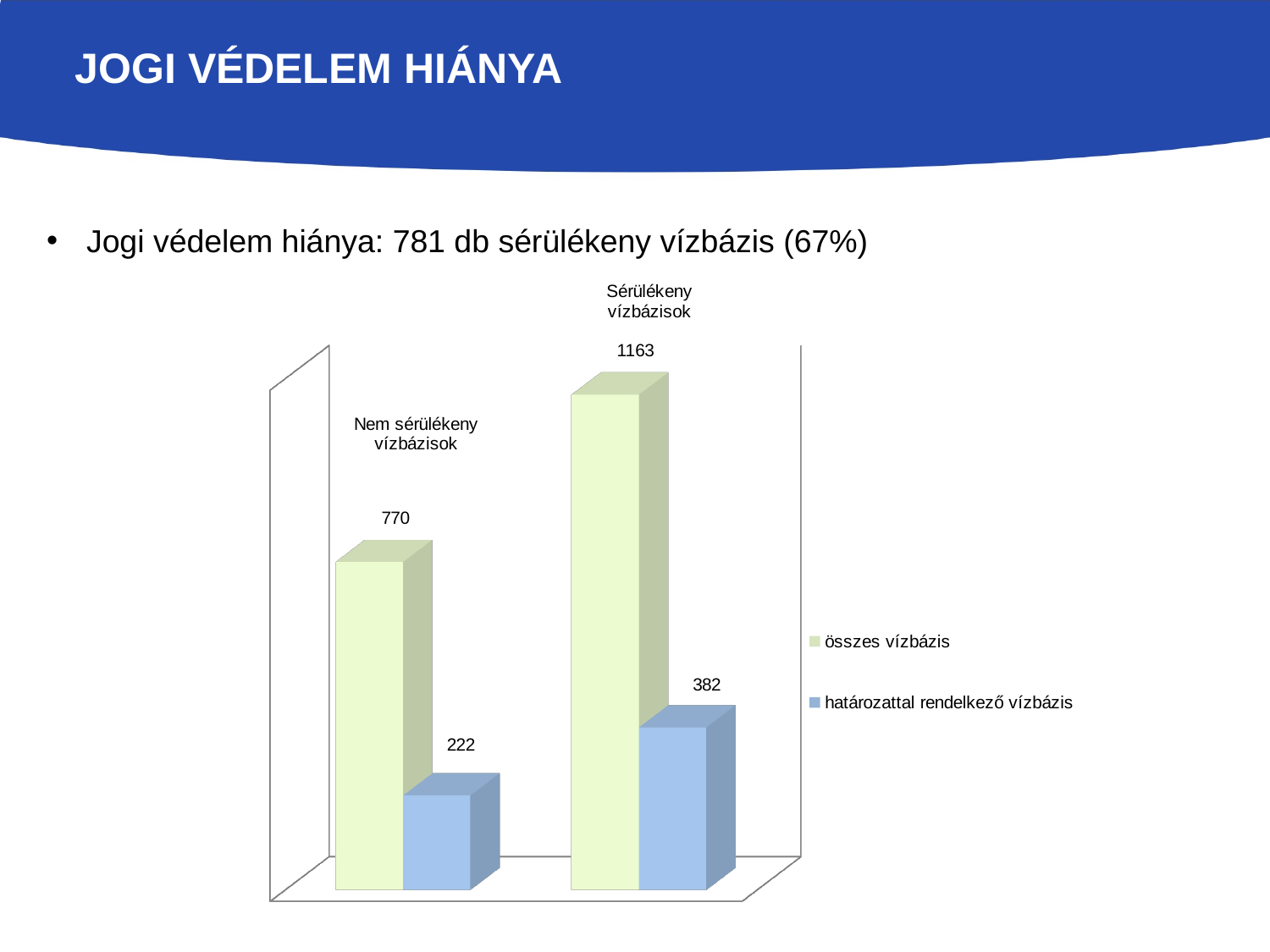
What is the value of 'határozattal rendelkező vízbázis' for 'Nem sérülékeny vízbázisok'? 222 How many categories are shown in the chart? 2 What is the difference between 'összes vízbázis' and 'határozattal rendelkező vízbázis' for 'Nem sérülékeny vízbázisok'? 548 Which is larger: 'határozattal rendelkező vízbázis' for 'Sérülékeny vízbázisok' or 'összes vízbázis' for 'Nem sérülékeny vízbázisok'? összes vízbázis for Nem sérülékeny vízbázisok Which category has the lowest 'határozattal rendelkező vízbázis' value? Nem sérülékeny vízbázisok How many series does the legend list? 2 What is the value of 'határozattal rendelkező vízbázis' for 'Sérülékeny vízbázisok'? 382 What is the difference between 'összes vízbázis' and 'határozattal rendelkező vízbázis' for 'Sérülékeny vízbázisok'? 781 What kind of chart is shown on the slide? Bar chart What is the value of 'összes vízbázis' for 'Nem sérülékeny vízbázisok'? 770 Which category has the highest 'összes vízbázis' value? Sérülékeny vízbázisok What is the value of 'összes vízbázis' for 'Sérülékeny vízbázisok'? 1163